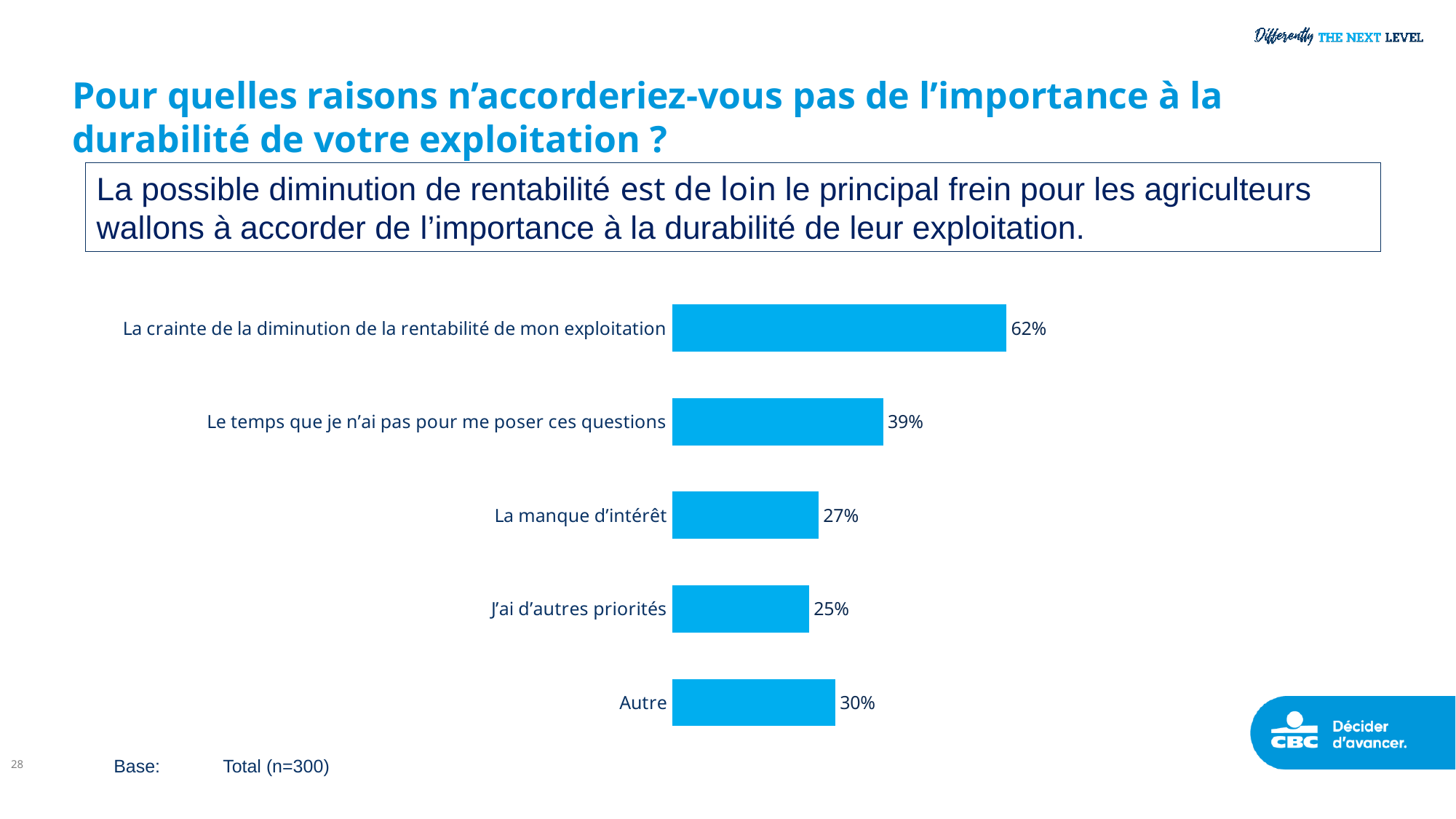
What kind of chart is shown on the slide? Bar chart Which is larger, the value for "Autre" or the value for "La manque d'intérêt"? Autre What is the difference between the values for "Autre" and "J'ai d'autres priorités"? 5% What percentage is shown for "La manque d'intérêt"? 27% Which category has the lowest value? J'ai d'autres priorités Which category has the highest value? La crainte de la diminution de la rentabilité de mon exploitation What value is shown for "Le temps que je n'ai pas pour me poser ces questions"? 39% How many categories are shown in the chart? 5 What value is shown for "Autre"? 30% What percentage is shown for "La crainte de la diminution de la rentabilité de mon exploitation"? 62% What is the base (sample size) stated at the bottom of the slide? Total (n=300) What is the difference between the values for "La crainte de la diminution de la rentabilité de mon exploitation" and "Le temps que je n'ai pas pour me poser ces questions"? 23%